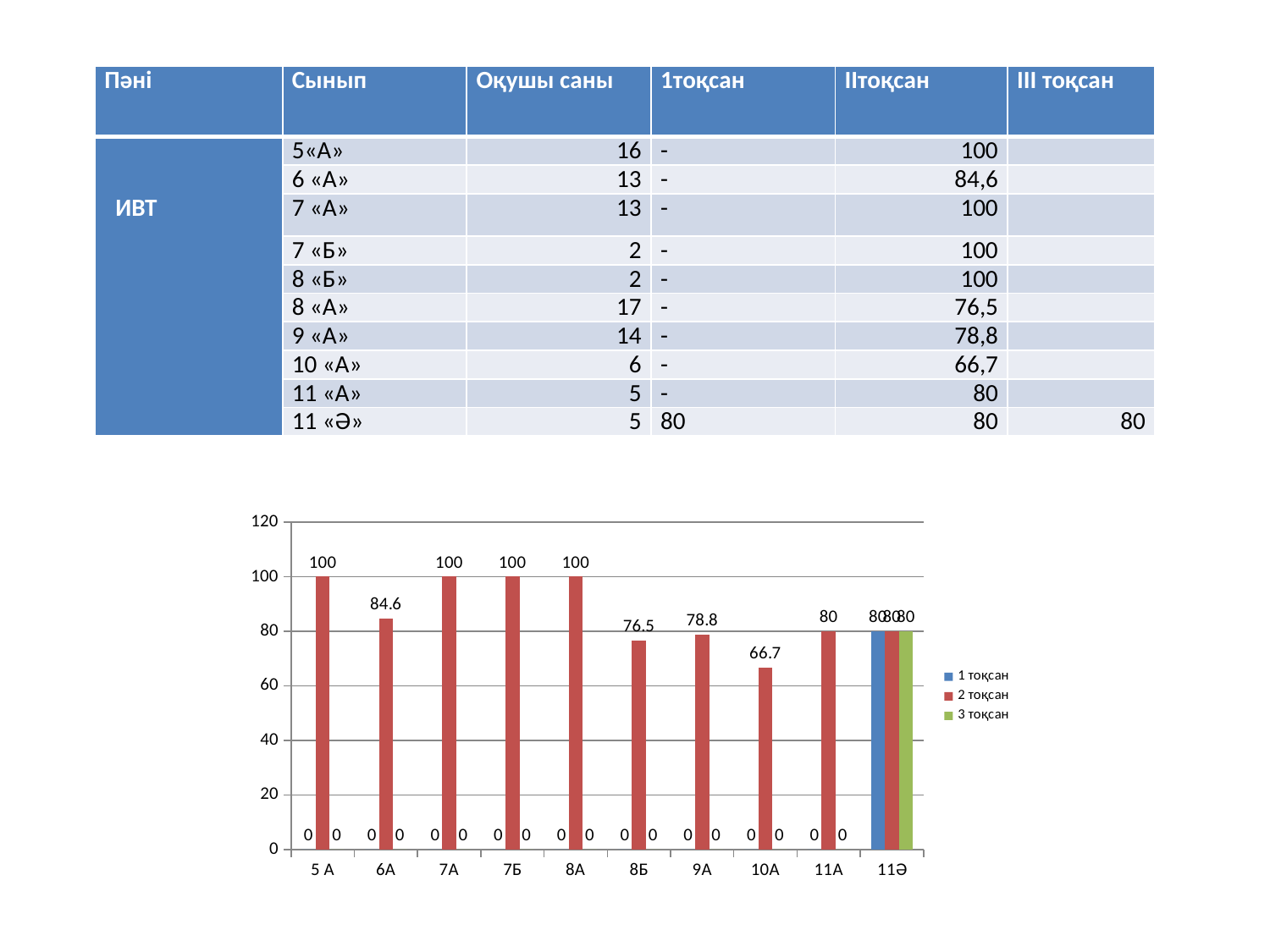
How many categories are shown on the x axis of the chart? 10 Is the 2 тоқсан value for 8Б in the chart greater or less than 80? less What is the difference between the 2 тоқсан values for 5 A and 10A in the chart? 33.3 What is the value of the 2 тоқсан series for 9A in the chart? 78.8 Which category has the lowest 2 тоқсан value in the chart? 10A How many series does the chart legend list? 3 What kind of chart is shown on the slide? bar chart What is the value of the 2 тоқсан series for 10A in the chart? 66.7 What is the value of the 2 тоқсан series for 6A in the chart? 84.6 In the chart, which is larger: the 2 тоқсан value for 6A or for 8Б? 6A What is the value of the 1 тоқсан series for 11Ә in the chart? 80 Which category in the chart is the only one with non-zero values for all three series? 11Ә